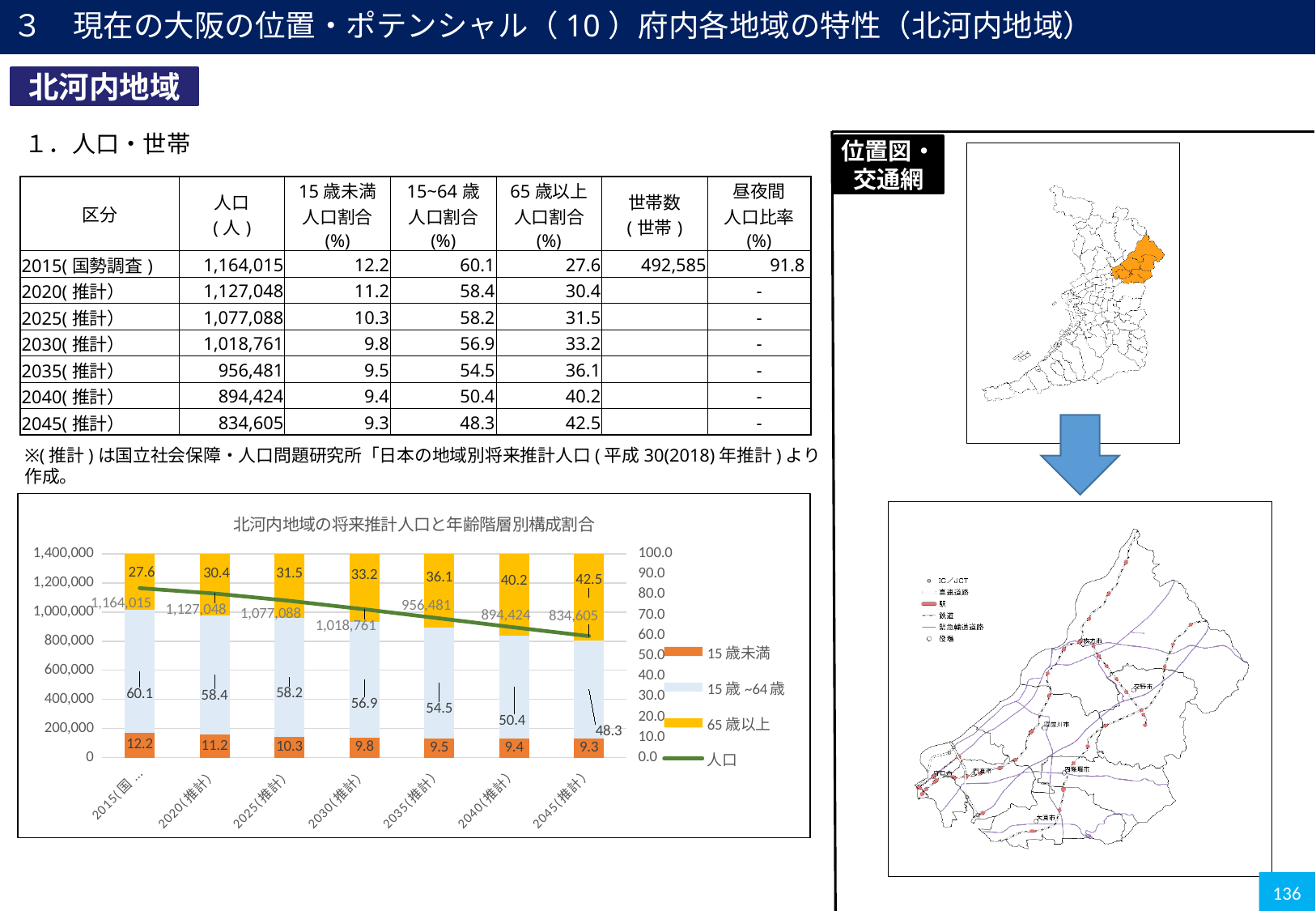
In the chart, which is larger, the 人口 value for 2020(推計) or for 2025(推計)? 2020(推計) How many series does the chart's legend list? 4 How many year categories are shown on the x axis of the chart? 7 What kind of chart is 北河内地域の将来推計人口と年齢階層別構成割合? Stacked bar chart with a line In the chart, what is the 15歳未満 share for 2020(推計)? 11.2 In the chart, what is the difference between the 15歳~64歳 share in 2015 and in 2045(推計)? 11.8 In the chart, which year has the highest 65歳以上 share? 2045(推計) In the chart 北河内地域の将来推計人口と年齢階層別構成割合, what is the 65歳以上 share for 2045(推計)? 42.5 In the chart, what is the 人口 value for 2030(推計)? 1,018,761 In the chart, which year has the lowest 15歳~64歳 share? 2045(推計) In the chart, does the 人口 line rise or fall from 2015 to 2045? Falls In the chart, what is the total of the stacked bar for 2040(推計)? 100.0